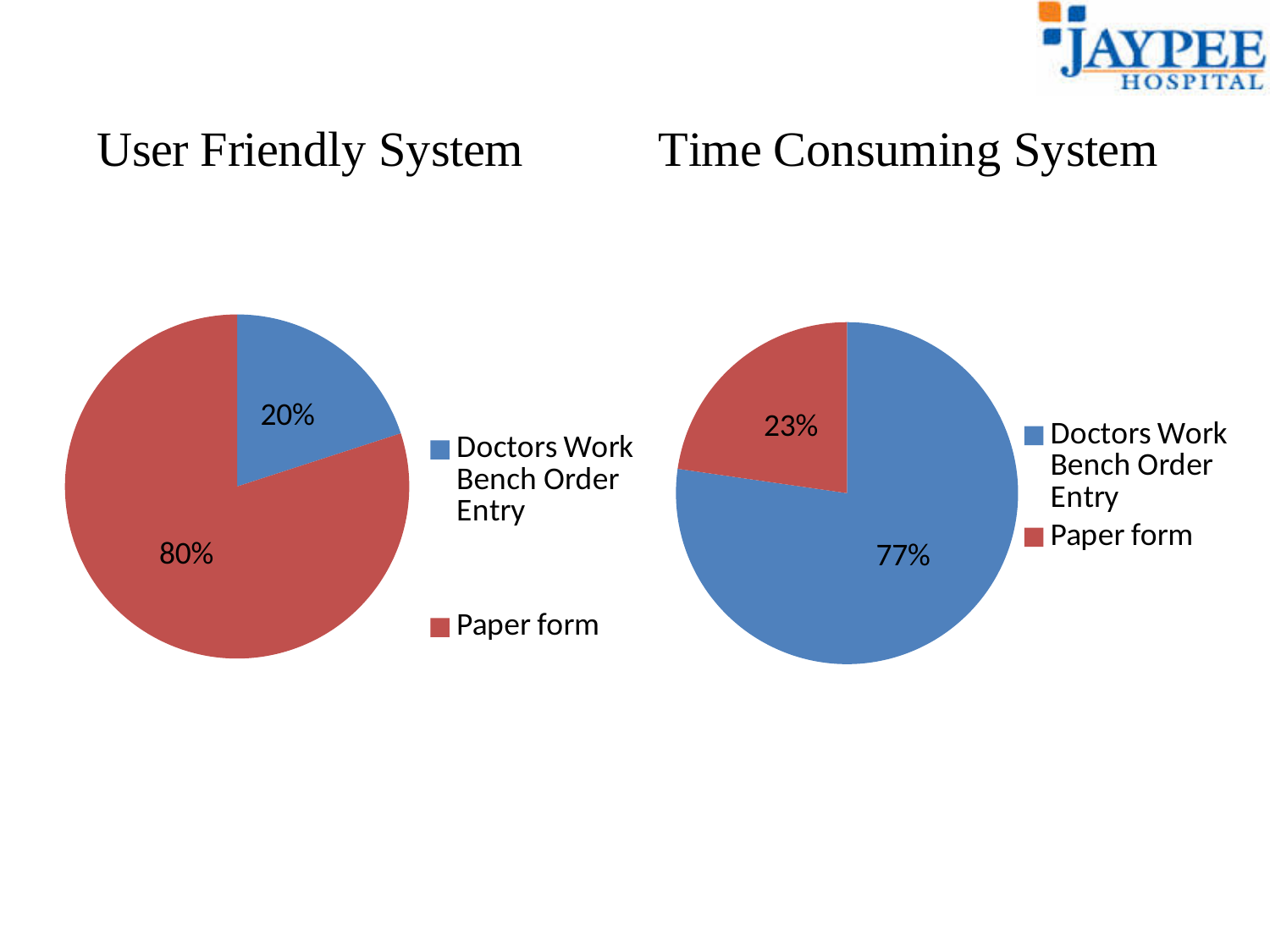
In the Time Consuming System pie chart, which slice is the smallest? Paper form In the User Friendly System pie chart, what colour is the Paper form slice? Red In the Time Consuming System pie chart, which is larger: Doctors Work Bench Order Entry or Paper form? Doctors Work Bench Order Entry In the User Friendly System pie chart, what is the difference between the Paper form share and the Doctors Work Bench Order Entry share? 60% What kind of chart is used on the left of the slide, under User Friendly System? Pie chart In the Time Consuming System pie chart, what share is labelled for Doctors Work Bench Order Entry? 77% In the User Friendly System pie chart, what share is labelled for Paper form? 80% In the User Friendly System pie chart, which slice is the largest? Paper form In the Time Consuming System pie chart, what share is labelled for Paper form? 23% How many slices does the Time Consuming System pie chart have? 2 In the Time Consuming System pie chart, what is the difference between the Doctors Work Bench Order Entry share and the Paper form share? 54% In the User Friendly System pie chart, what share is labelled for Doctors Work Bench Order Entry? 20%